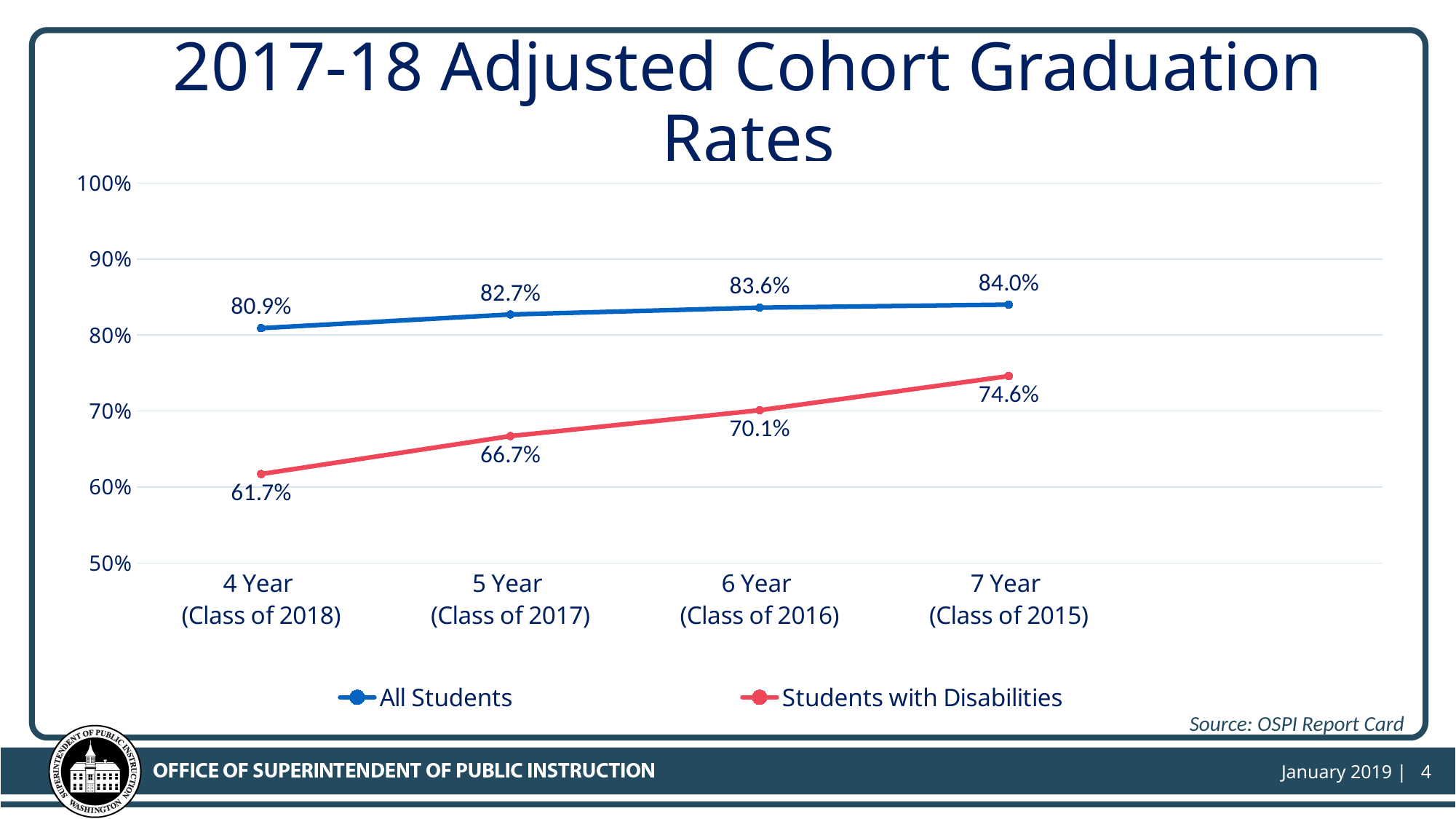
What is the 7 Year (Class of 2015) graduation rate for Students with Disabilities? 74.6% Which cohort has the lowest graduation rate for Students with Disabilities? 4 Year (Class of 2018) What is the 6 Year (Class of 2016) graduation rate for Students with Disabilities? 70.1% Which cohort has the highest graduation rate for All Students? 7 Year (Class of 2015) How many series does the legend list? 2 By how much did the Students with Disabilities rate increase from the 4 Year cohort to the 7 Year cohort? 12.9% Which is larger: the 6 Year rate for All Students or the 7 Year rate for Students with Disabilities? 6 Year rate for All Students What is the difference between the All Students and Students with Disabilities rates for the 5 Year (Class of 2017) cohort? 16.0% How many cohorts are plotted on the x axis? 4 What is the 4 Year (Class of 2018) graduation rate for All Students? 80.9% What kind of chart is shown on the slide? Line chart Do the Students with Disabilities graduation rates rise or fall from the 4 Year cohort to the 7 Year cohort? Rise